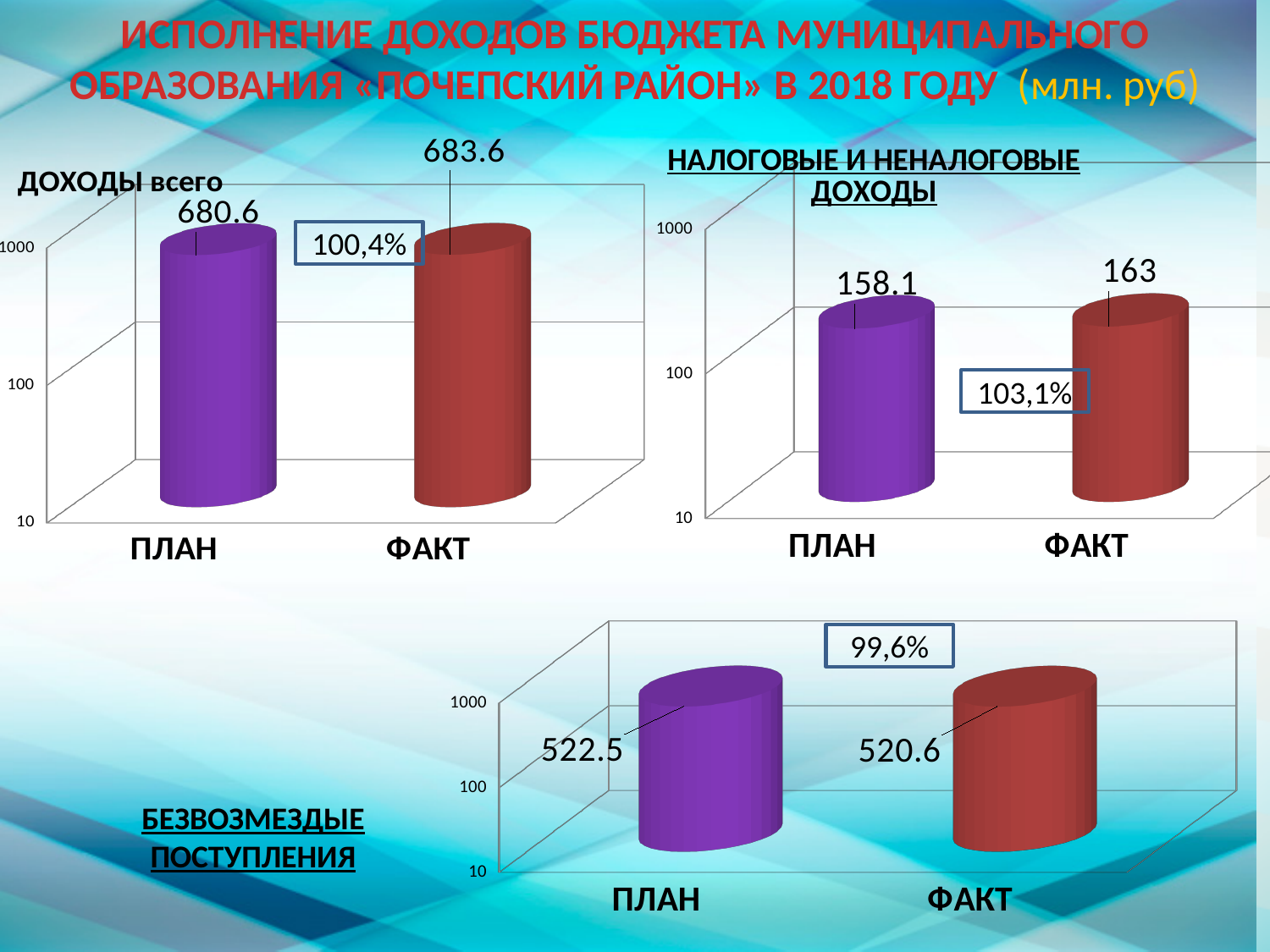
In the 'ДОХОДЫ всего' chart, what is the value for ФАКТ? 683.6 In the 'ДОХОДЫ всего' chart, what is the value for ПЛАН? 680.6 How many categories are shown in the 'ДОХОДЫ всего' chart? 2 In the 'БЕЗВОЗМЕЗДНЫЕ ПОСТУПЛЕНИЯ' chart, which is larger, ПЛАН or ФАКТ? ПЛАН In the 'НАЛОГОВЫЕ И НЕНАЛОГОВЫЕ ДОХОДЫ' chart, what is the value for ФАКТ? 163 In the 'НАЛОГОВЫЕ И НЕНАЛОГОВЫЕ ДОХОДЫ' chart, what is the difference between ФАКТ and ПЛАН? 4.9 In the 'ДОХОДЫ всего' chart, what is the difference between ФАКТ and ПЛАН? 3 In the 'НАЛОГОВЫЕ И НЕНАЛОГОВЫЕ ДОХОДЫ' chart, is the value for ПЛАН greater or less than 100? greater In the 'БЕЗВОЗМЕЗДНЫЕ ПОСТУПЛЕНИЯ' chart, what is the value for ПЛАН? 522.5 In the 'БЕЗВОЗМЕЗДНЫЕ ПОСТУПЛЕНИЯ' chart, which category has the lowest value? ФАКТ In the 'НАЛОГОВЫЕ И НЕНАЛОГОВЫЕ ДОХОДЫ' chart, which category has the highest value? ФАКТ What percentage is shown in the box on the 'БЕЗВОЗМЕЗДНЫЕ ПОСТУПЛЕНИЯ' chart? 99,6%